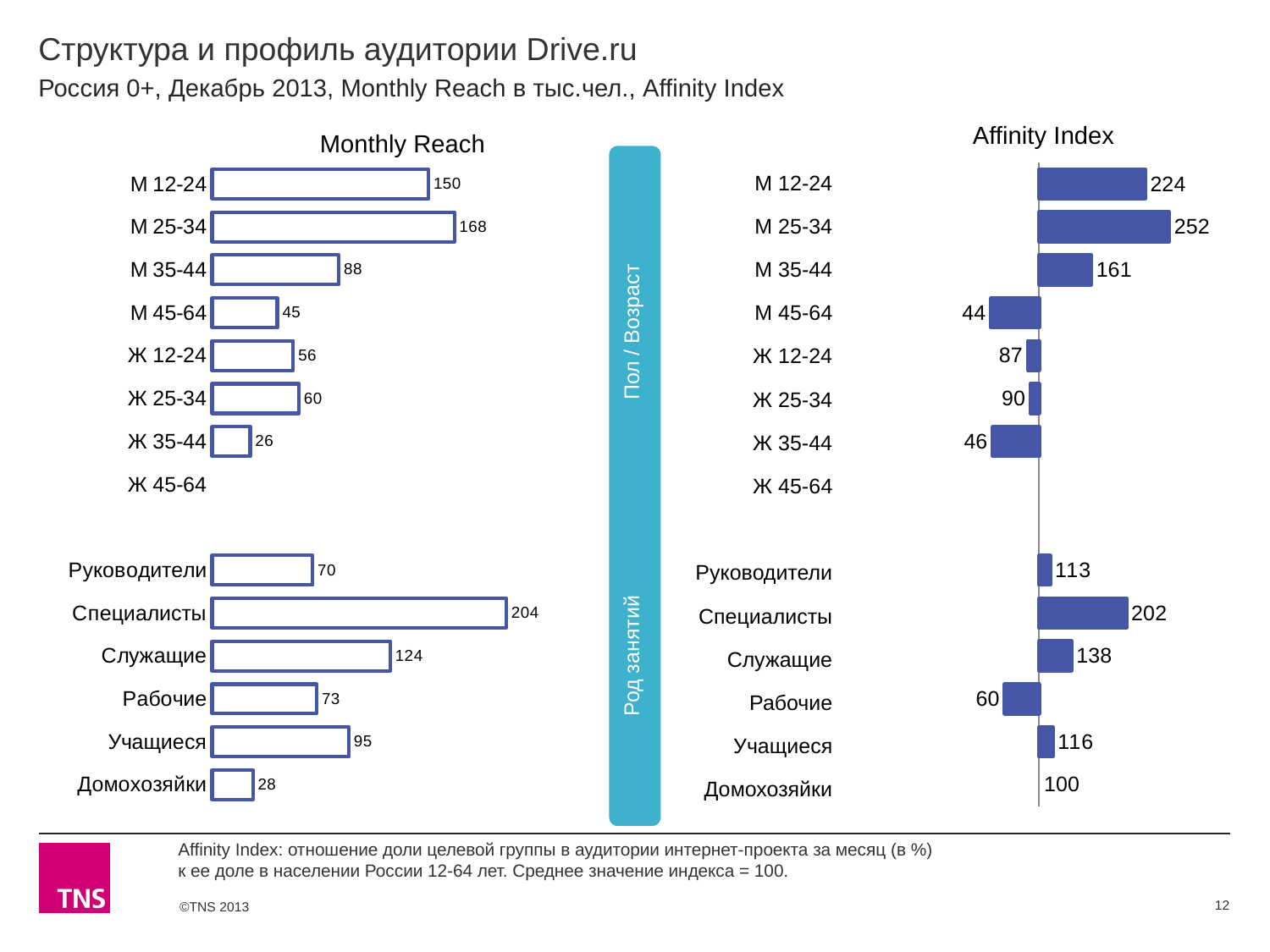
In the Monthly Reach chart, what is the value for М 25-34? 168 In the Affinity Index chart, which category has the lowest value? М 45-64 What kind of chart is the Affinity Index chart? Bar chart In the Monthly Reach chart, which category has the highest value? Специалисты In the Affinity Index chart, what is the difference between М 25-34 and М 12-24? 28 In the Affinity Index chart, which is larger: Руководители or Служащие? Служащие In the Monthly Reach chart, what is the value for Домохозяйки? 28 In the Monthly Reach chart, what is the difference between М 12-24 and М 35-44? 62 In the Affinity Index chart, what is the value for Домохозяйки? 100 In the Monthly Reach chart, which is larger: Служащие or Учащиеся? Служащие In the Affinity Index chart, what is the value for Специалисты? 202 In the Affinity Index chart, which gender/age group has the highest value? М 25-34